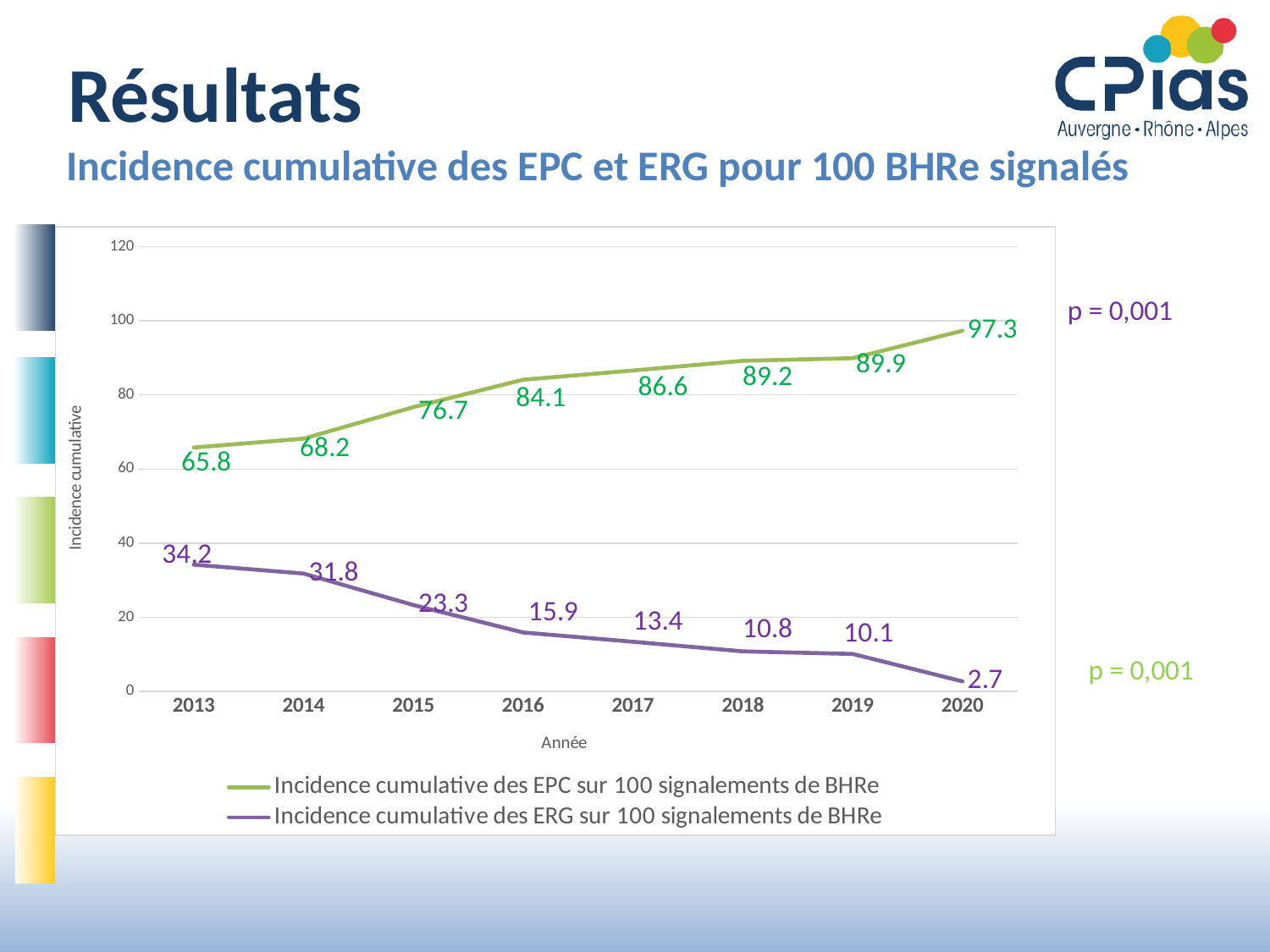
What is the difference between the EPC value in 2020 and the EPC value in 2013? 31.5 Which series has the larger value in 2015, EPC or ERG? EPC What is the label of the y axis? Incidence cumulative What kind of chart is shown on the slide? line chart Does the ERG series rise or fall from 2013 to 2020? fall Is the ERG value in 2014 greater or less than 40? less What is the value of the ERG series (Incidence cumulative des ERG sur 100 signalements de BHRe) in 2013? 34.2 How many series does the legend list? 2 How many years are shown on the x axis? 8 In which year is the ERG series at its lowest value? 2020 What is the value of the EPC series (Incidence cumulative des EPC sur 100 signalements de BHRe) in 2016? 84.1 In which year does the EPC series reach its highest value? 2020